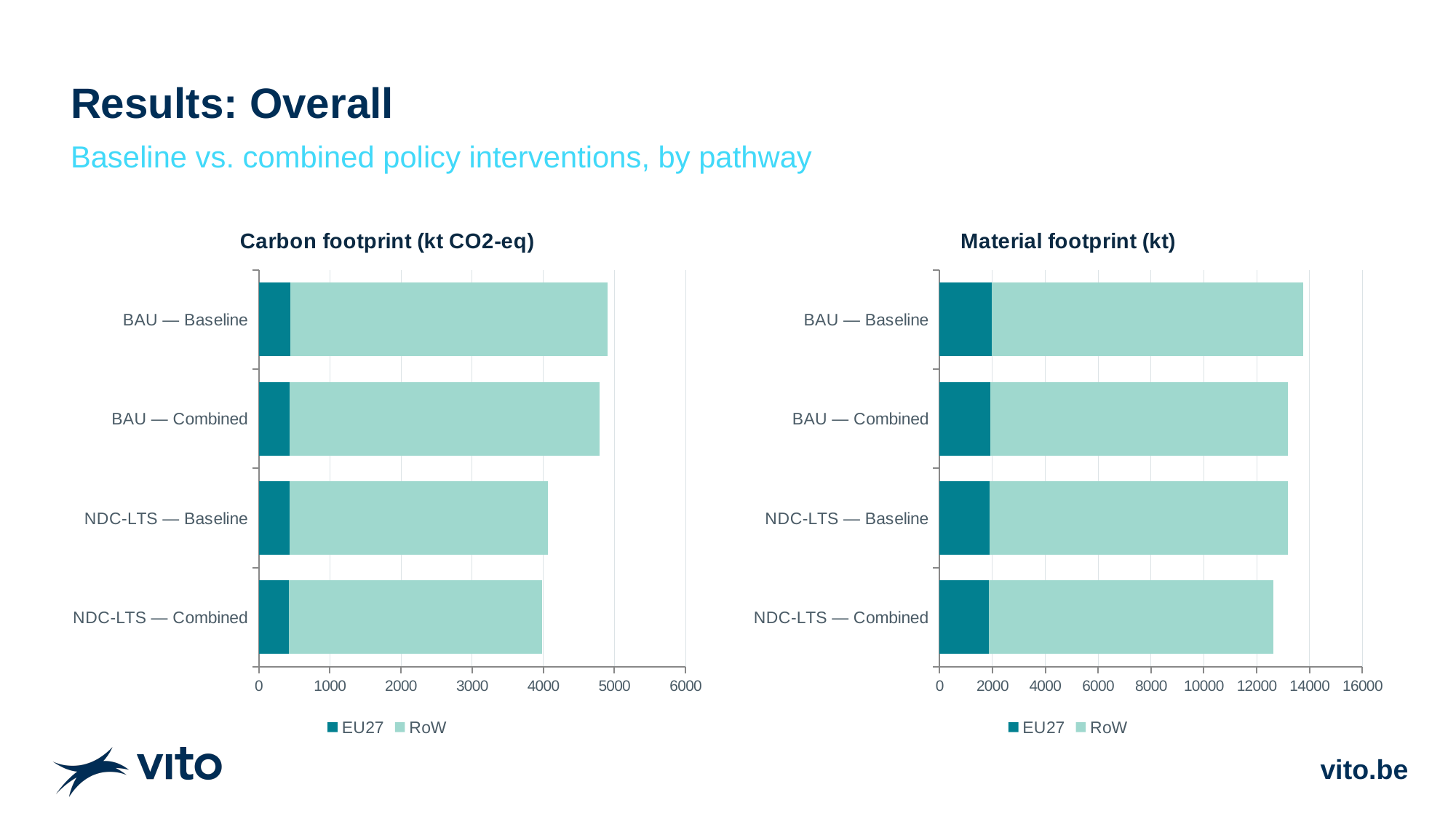
In the Carbon footprint (kt CO2-eq) chart, which category has the shortest total bar? NDC-LTS — Combined What are the two legend entries of the Material footprint (kt) chart? EU27 and RoW In the Carbon footprint (kt CO2-eq) chart, which has the larger total: BAU — Combined or NDC-LTS — Baseline? BAU — Combined What kind of chart is the Carbon footprint (kt CO2-eq) chart? Stacked bar chart In the Carbon footprint (kt CO2-eq) chart, which category has the longest total bar? BAU — Baseline In the Material footprint (kt) chart, which category has the shortest total bar? NDC-LTS — Combined How many categories are shown on the Material footprint (kt) chart? 4 How many series does the legend of the Carbon footprint (kt CO2-eq) chart list? 2 In the Carbon footprint (kt CO2-eq) chart, is the total value for NDC-LTS — Combined greater or less than 3000? greater In the Material footprint (kt) chart, is the total value for BAU — Baseline greater or less than 12000? greater In the Material footprint (kt) chart, which category has the longest total bar? BAU — Baseline In the Carbon footprint (kt CO2-eq) chart, is the total value for BAU — Baseline greater or less than 4000? greater